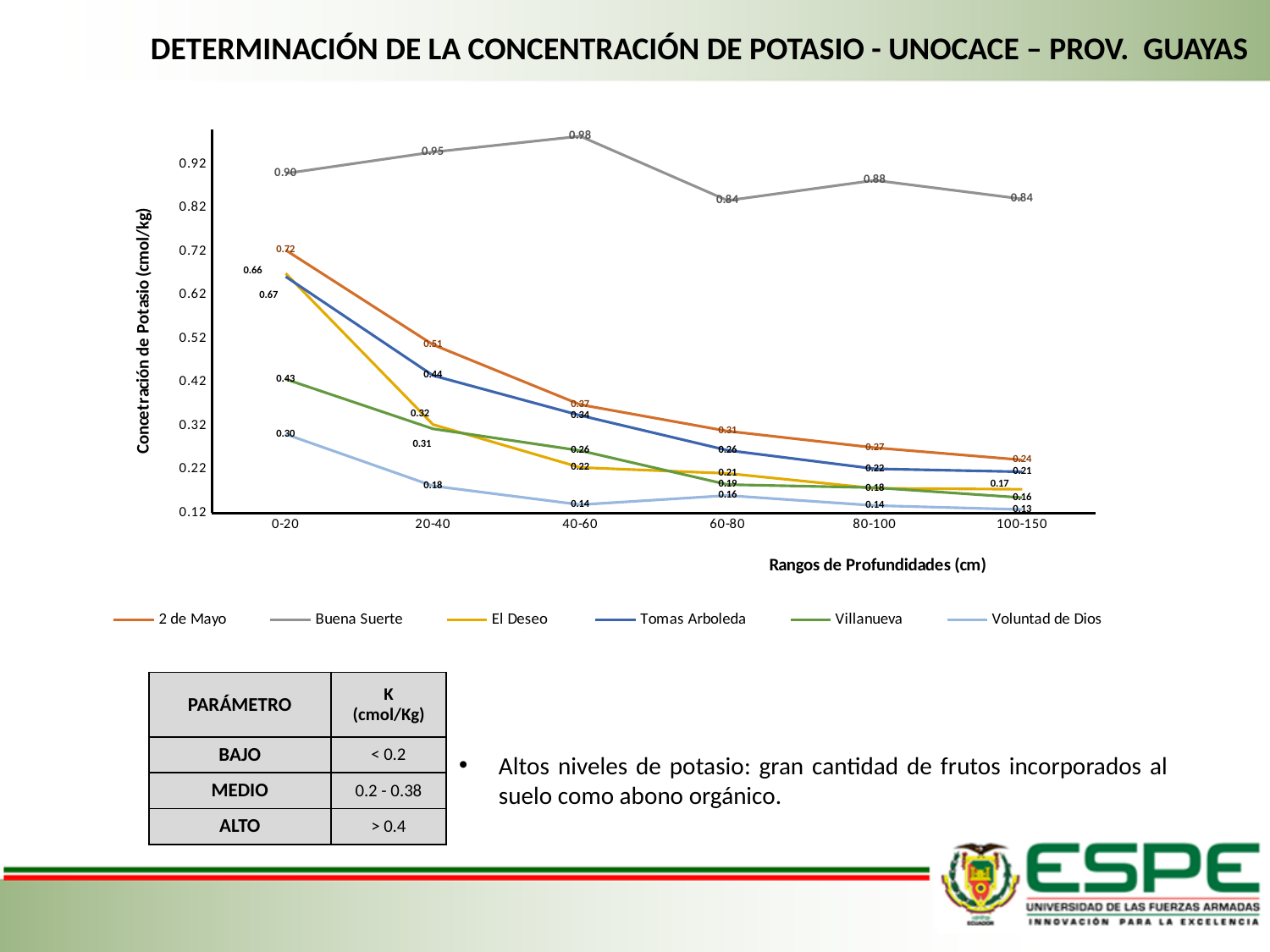
Is the value for Buena Suerte at 80-100 cm greater or less than 0.82? greater What is the value for Voluntad de Dios at the 100-150 cm depth range? 0.13 Which series has the highest potassium concentration across all depth ranges? Buena Suerte How many series does the legend list? 6 What kind of chart is shown on the slide? Line chart What is the value for 2 de Mayo at the 0-20 cm depth range? 0.72 How many depth ranges are shown on the x axis? 6 For Buena Suerte, which depth range has the larger value: 40-60 or 60-80? 40-60 Which series has the lowest value at the 0-20 cm depth range? Voluntad de Dios What is the difference between the 2 de Mayo values at 0-20 cm and 100-150 cm? 0.48 What is the value for Villanueva at the 0-20 cm depth range? 0.43 What is the potassium concentration for Buena Suerte at the 40-60 cm depth range? 0.98